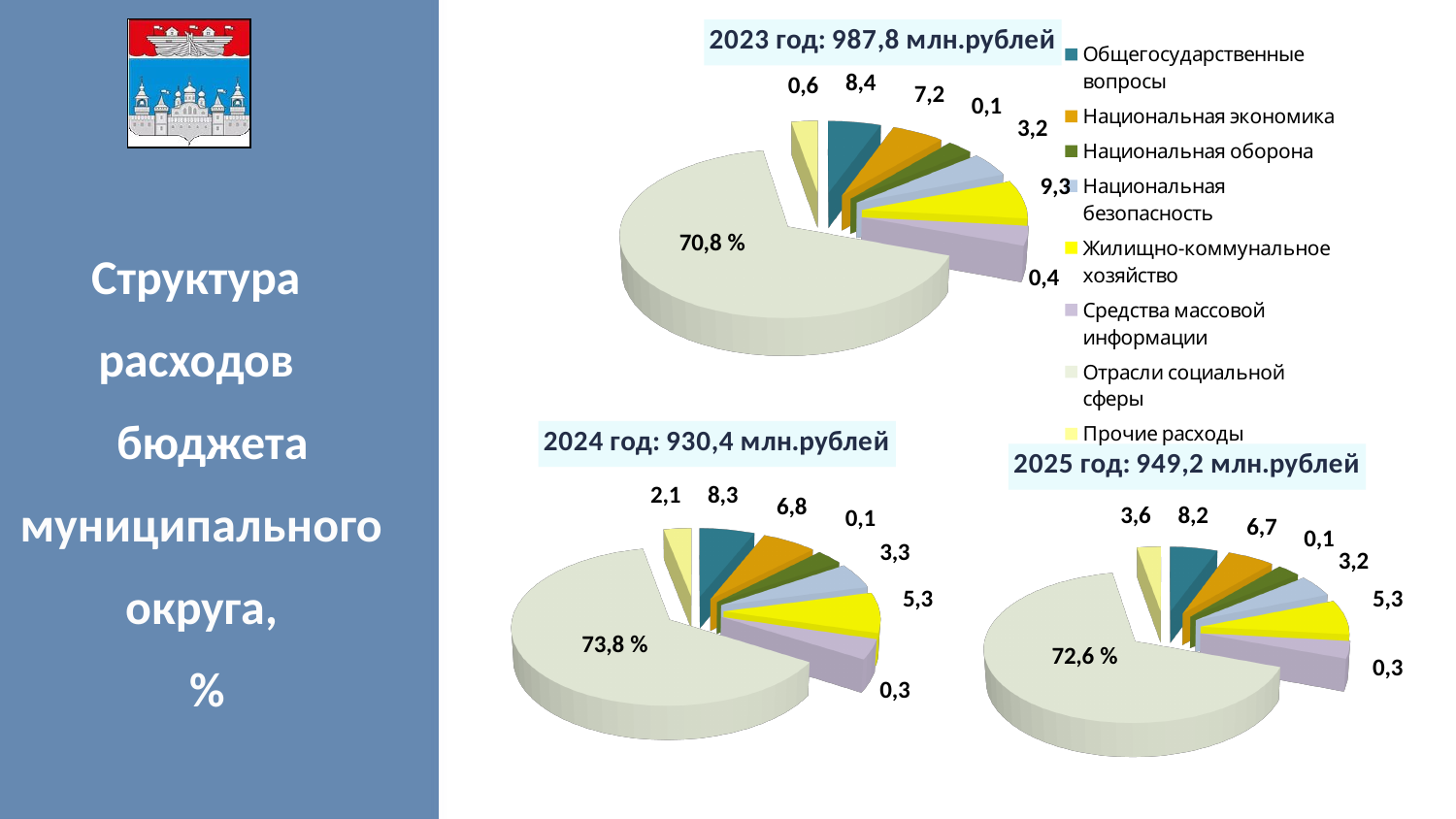
In the 2023 chart, what value is shown for Жилищно-коммунальное хозяйство? 9,3 What total budget amount is given in the title of the 2025 chart? 949,2 млн.рублей In the 2024 chart, what is the difference between Общегосударственные вопросы (8,3) and Национальная экономика (6,8)? 1,5 In the 2024 chart, which category has the smallest share? Национальная оборона In the 2024 chart, what share is labelled for Отрасли социальной сферы? 73,8 % In the 2025 chart, what value is shown for Общегосударственные вопросы? 8,2 How many categories does the legend list? 8 In the 2025 chart, which is larger: Национальная экономика or Национальная безопасность? Национальная экономика What kind of charts are shown on the slide? Pie charts In the 2023 chart, what share is labelled for Отрасли социальной сферы? 70,8 % In the 2023 chart, which category has the largest share? Отрасли социальной сферы In the 2025 chart, what share is labelled for Отрасли социальной сферы? 72,6 %